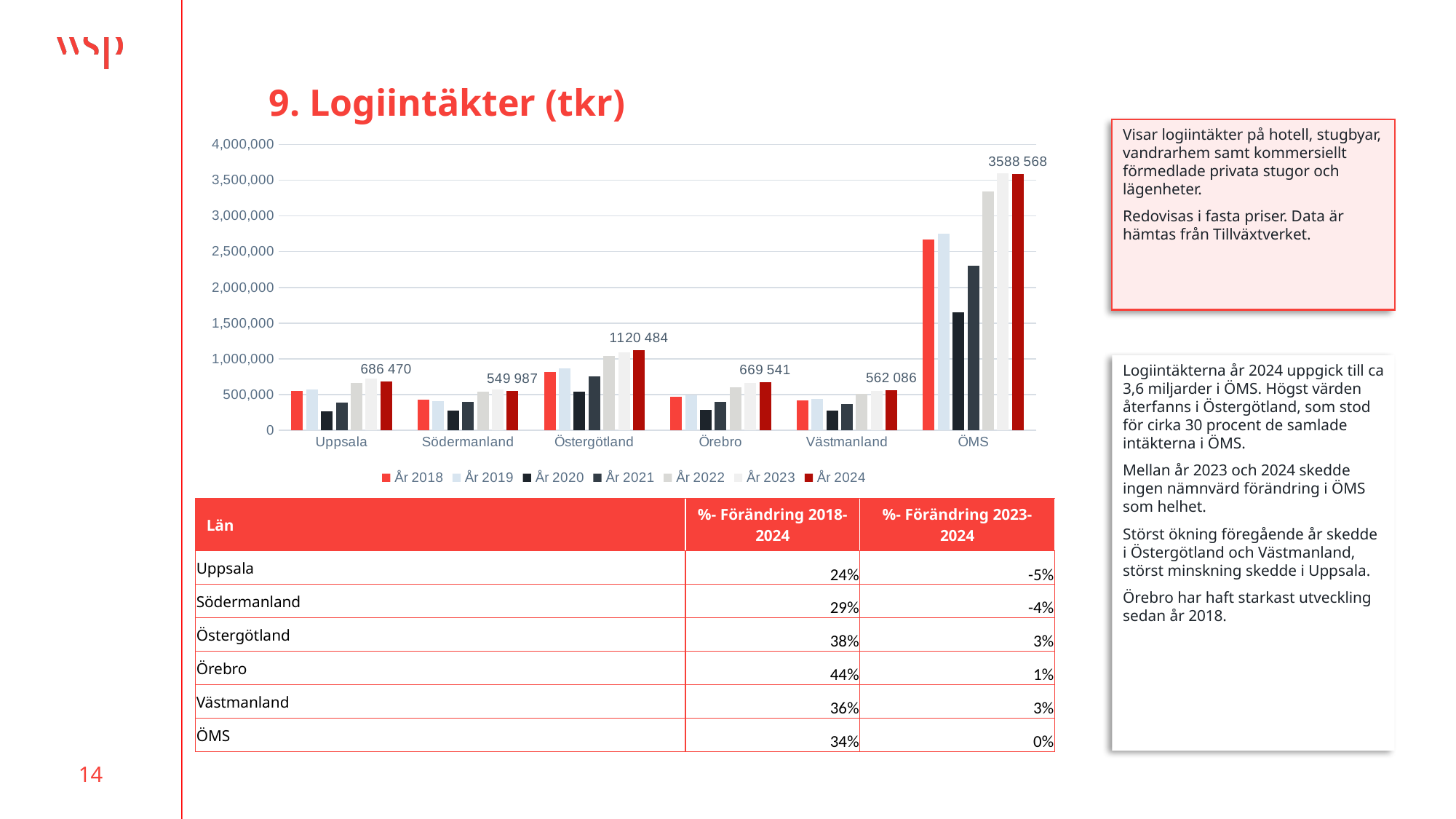
What is the value for Östergötland in År 2024? 1120 484 Which category has the highest value in År 2024? ÖMS How many series does the legend list? 7 What is the value for ÖMS in År 2024? 3588 568 What kind of chart is shown on the slide? bar chart How many categories are shown on the x axis of the chart? 6 What is the value for Västmanland in År 2024? 562 086 What is the value for Uppsala in År 2024? 686 470 Which category has the lowest value in År 2024? Södermanland Which is larger in År 2024: Uppsala or Örebro? Uppsala What is the difference between the År 2024 values for Östergötland and Uppsala? 434 014 Is the value for ÖMS in År 2020 greater or less than 2,000,000? less